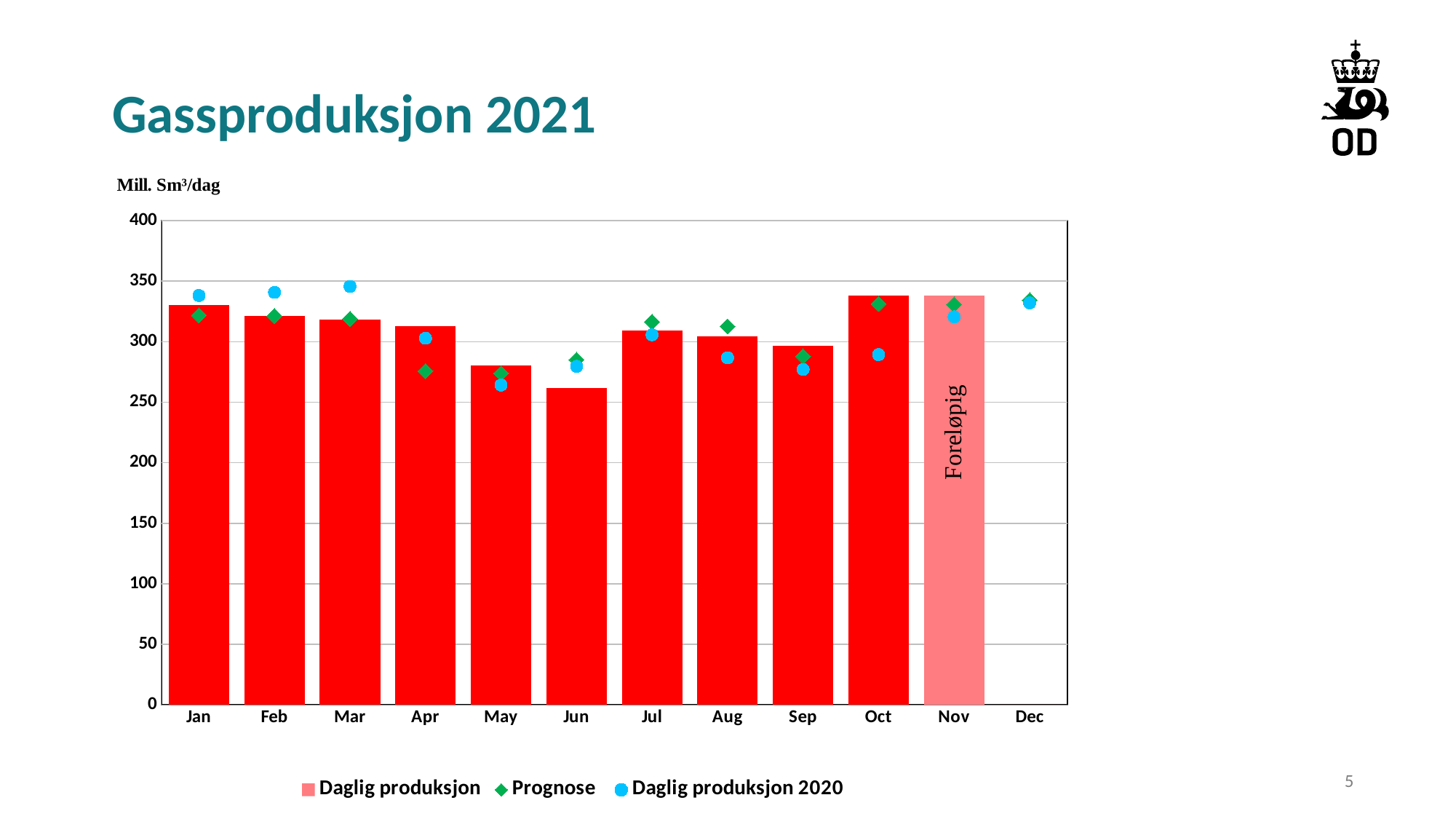
Is the Daglig produksjon value for May greater or less than 300? less How many series does the legend list? 3 Do the Daglig produksjon bars rise or fall from Jan to Jun? fall Which is larger, the Daglig produksjon bar for Jan or for Jun? Jan What is the title of the chart? Gassproduksjon 2021 What unit is shown above the y axis? Mill. Sm³/dag Is the Daglig produksjon value for Oct greater or less than 300? greater What kind of chart is shown on the slide? Combination chart: bars with point markers Which month has the lowest Daglig produksjon bar? Jun How many months are shown on the x axis? 12 Is the Daglig produksjon value for Jan greater or less than 300? greater